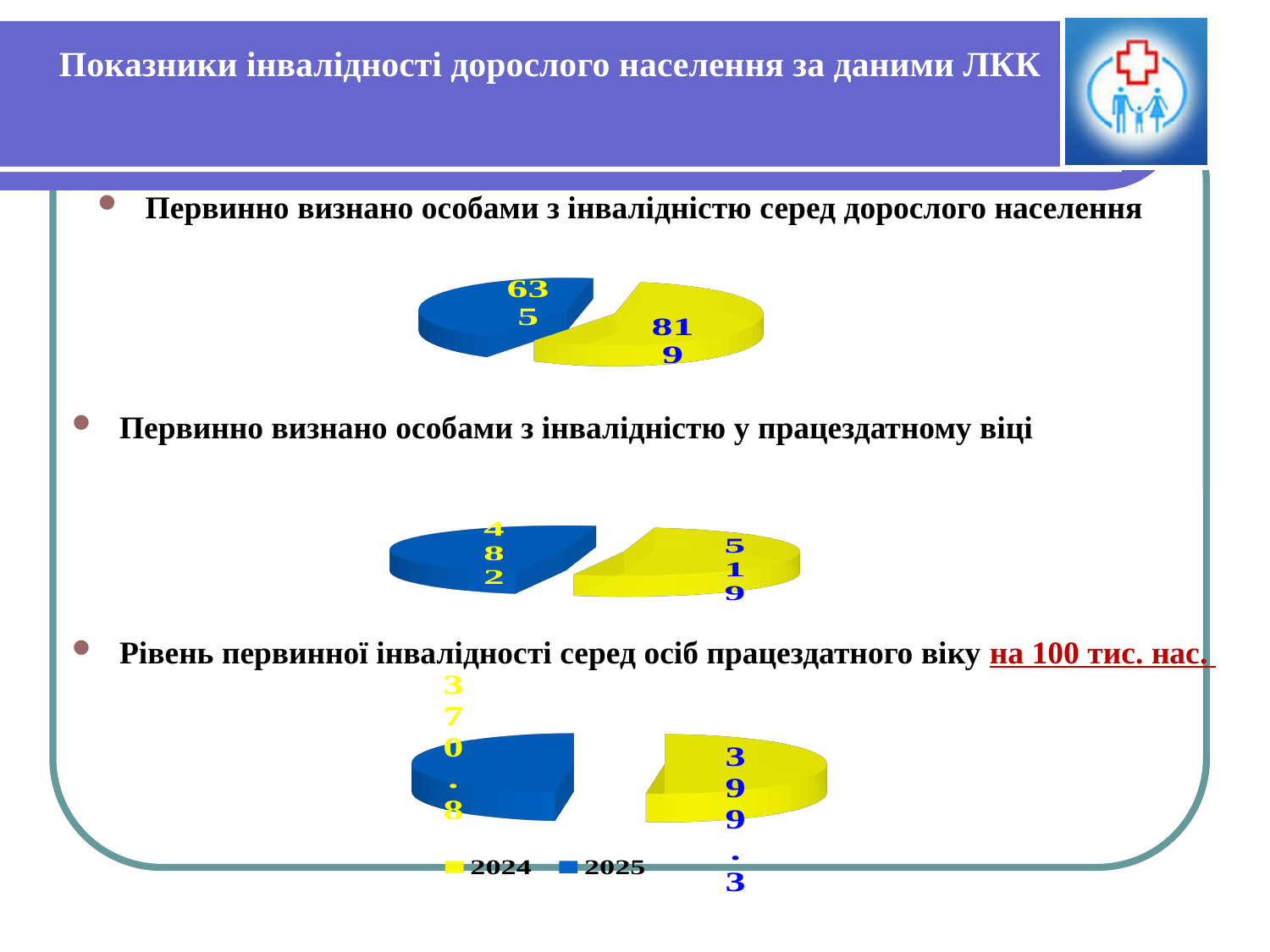
What kind of chart is used for "Первинно визнано особами з інвалідністю серед дорослого населення" (top chart)? pie chart In the middle chart ("Первинно визнано особами з інвалідністю у працездатному віці"), what value is shown for the blue (2025) slice? 482 In the middle chart, what is the difference between the 2024 value (519) and the 2025 value (482)? 37 In the top chart ("Первинно визнано особами з інвалідністю серед дорослого населення"), what value is shown for the yellow (2024) slice? 819 How many entries does the legend at the bottom of the slide list? 2 In the bottom chart ("Рівень первинної інвалідності серед осіб працездатного віку на 100 тис. нас."), what value is shown for the yellow (2024) slice? 399.3 In the middle chart ("Первинно визнано особами з інвалідністю у працездатному віці"), what value is shown for the yellow (2024) slice? 519 In the top chart ("Первинно визнано особами з інвалідністю серед дорослого населення"), what value is shown for the blue (2025) slice? 635 In the bottom chart ("Рівень первинної інвалідності серед осіб працездатного віку на 100 тис. нас."), what value is shown for the blue (2025) slice? 370.8 How many pie charts are shown on the slide? 3 In the top chart, what is the difference between the 2024 value (819) and the 2025 value (635)? 184 In the top chart, which slice is larger, the yellow (2024) or the blue (2025)? yellow (2024)